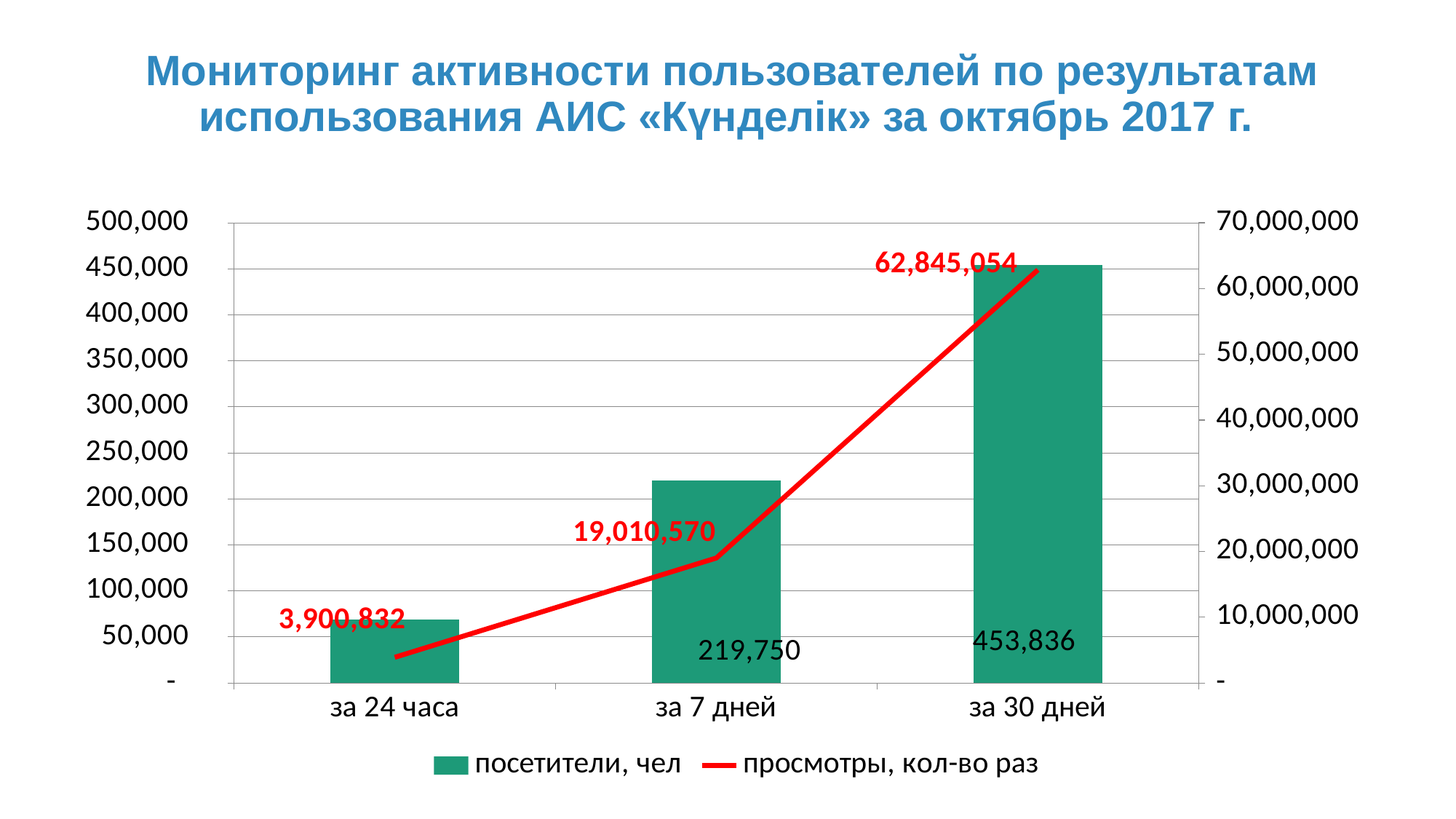
What is the number of views (просмотры, кол-во раз) for за 7 дней? 19,010,570 Which period has the lowest number of views? за 24 часа What is the number of visitors (посетители, чел) for за 7 дней? 219,750 Is the number of visitors for за 24 часа greater or less than 100,000? less What is the number of views (просмотры, кол-во раз) for за 30 дней? 62,845,054 What is the number of views (просмотры, кол-во раз) for за 24 часа? 3,900,832 How many series does the legend list? 2 Which period has the highest number of visitors? за 30 дней What is the difference in views between за 30 дней and за 7 дней? 43,834,484 By how much do visitors for за 30 дней exceed visitors for за 7 дней? 234,086 What is the number of visitors (посетители, чел) for за 30 дней? 453,836 Do the views rise or fall from за 24 часа to за 30 дней? rise